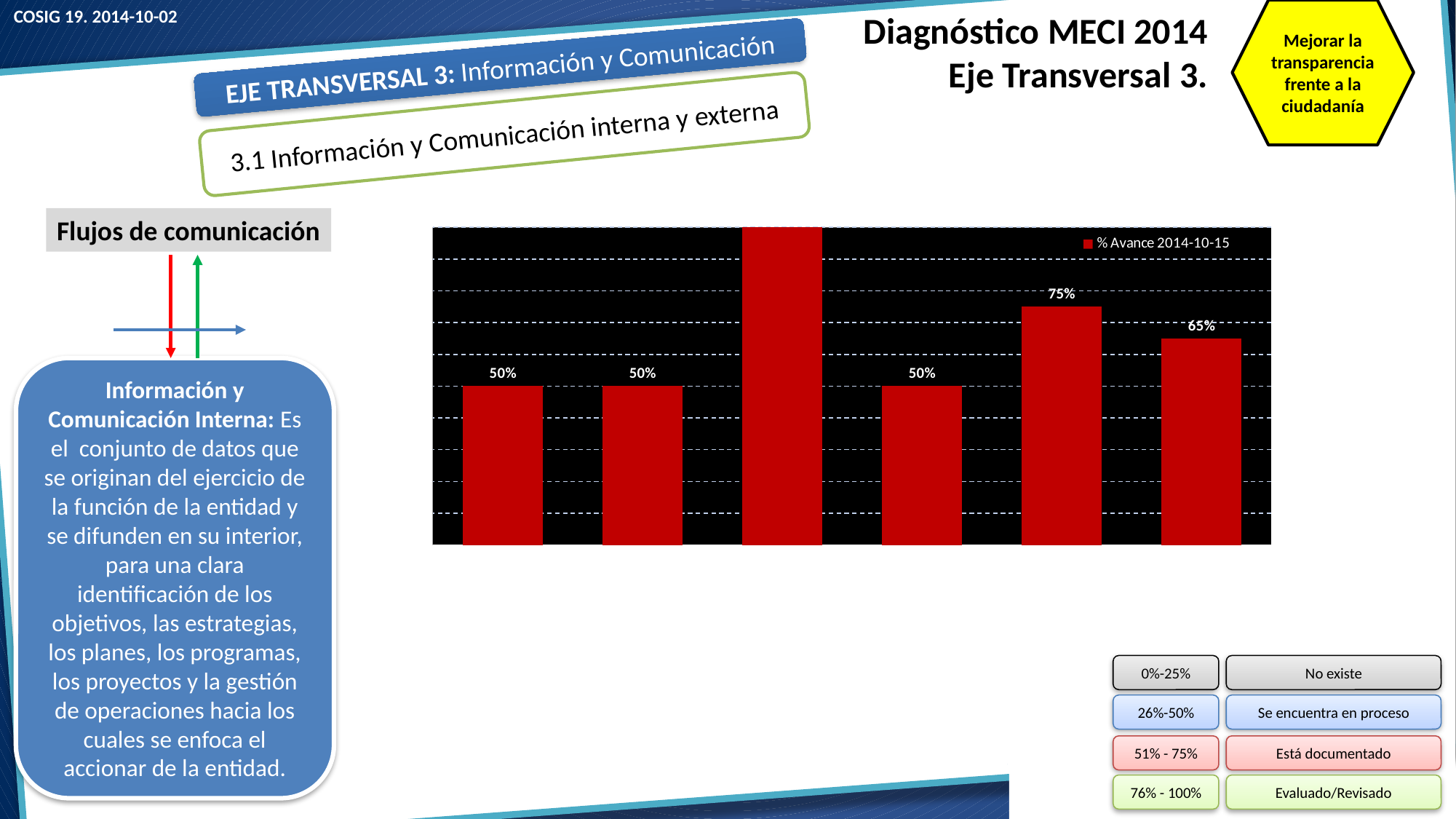
How many series does the chart legend list? 1 What value is labelled on the sixth bar from the left (the rightmost bar)? 65% What colour are the bars in the chart? red Which bar is the tallest in the chart? the third bar from the left What kind of chart is shown on the slide? bar chart What is the series name shown in the chart legend? % Avance 2014-10-15 What is the difference between the fifth bar (75%) and the sixth bar (65%)? 10 percentage points How many bars does the chart contain? 6 What value is labelled on the fourth bar from the left? 50% What value is labelled on the fifth bar from the left? 75% What value is labelled on the first bar from the left? 50% Which is larger, the fifth bar from the left or the sixth bar from the left? the fifth bar (75%)